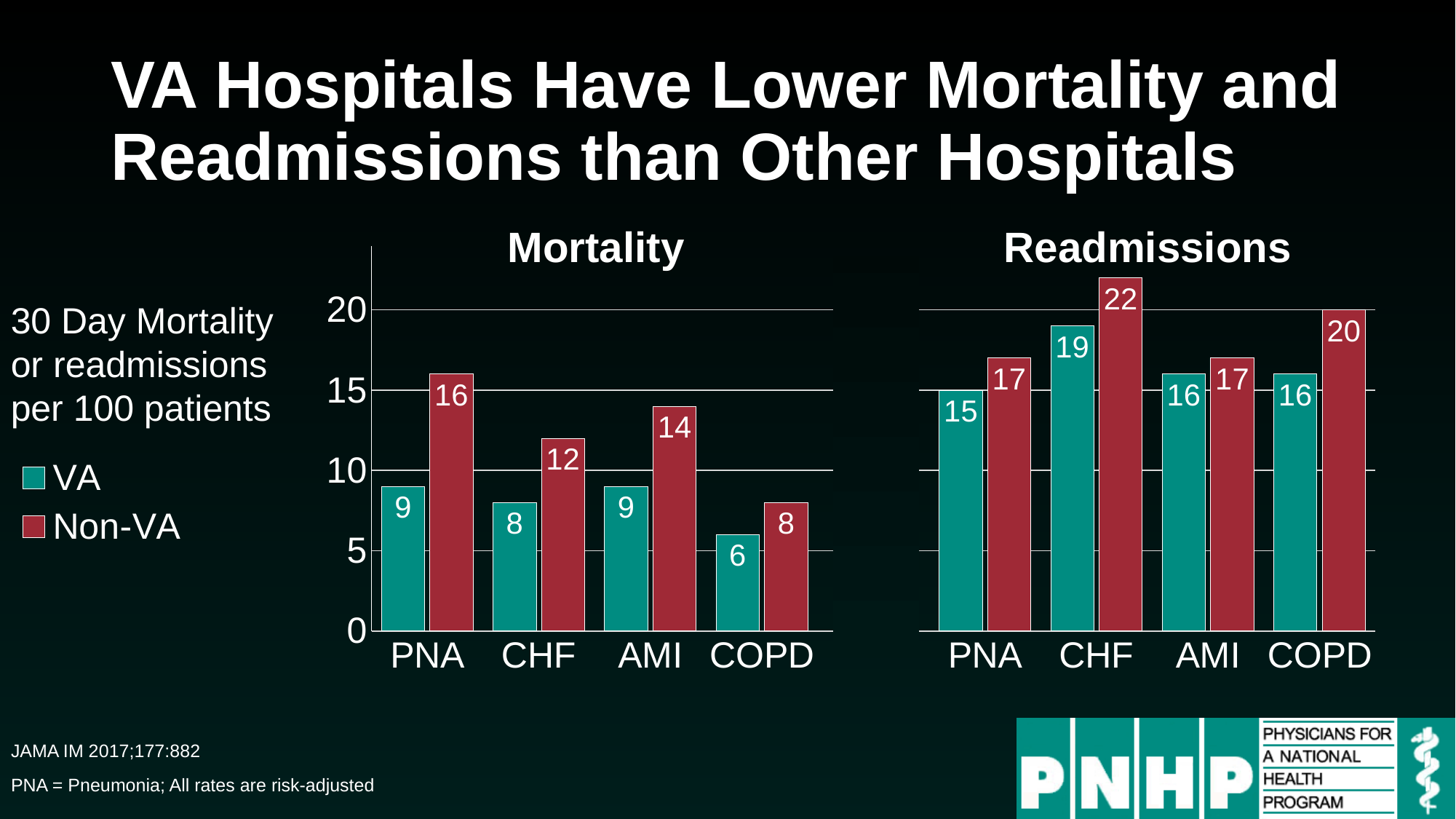
In the Mortality chart, which is larger for AMI: the VA value or the Non-VA value? Non-VA In the Readmissions chart, what is the difference between the Non-VA and VA values for COPD? 4 What kind of chart is the Readmissions chart? bar chart In the Readmissions chart, is the Non-VA value for CHF greater or less than 20? greater In the Mortality chart, what is the difference between the Non-VA and VA values for PNA? 7 In the Mortality chart, which category has the highest Non-VA value? PNA In the Mortality chart, what is the Non-VA value for PNA? 16 How many categories are shown on the x axis of the Mortality chart? 4 How many series does the legend list? 2 In the Readmissions chart, what is the VA value for CHF? 19 In the Mortality chart, which category has the lowest VA value? COPD In the Readmissions chart, which category has the highest Non-VA value? CHF